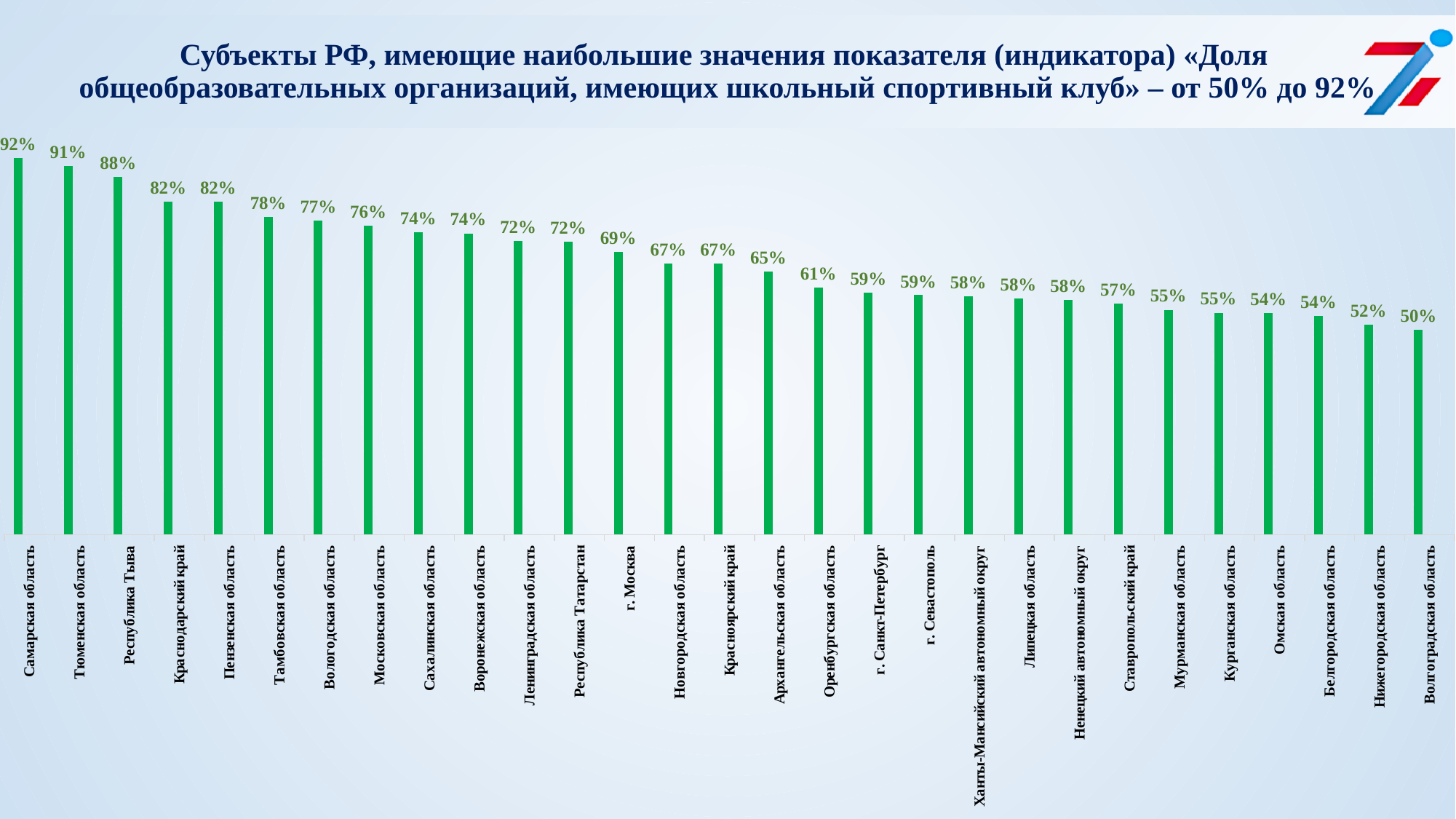
What kind of chart is shown on the slide? Bar chart Do the values rise or fall from left to right along the x axis? Fall What is the value for Оренбургская область? 61% What is the difference between the values for Тюменская область and Московская область? 15% What is the value for Республика Тыва? 88% What is the value for Ставропольский край? 57% What is the value for г. Москва? 69% What is the difference between the values for Самарская область and Волгоградская область? 42% Which has a larger value, Тамбовская область or Архангельская область? Тамбовская область How many regions are shown in the chart? 29 Which region has the lowest value? Волгоградская область Which region has the highest value? Самарская область